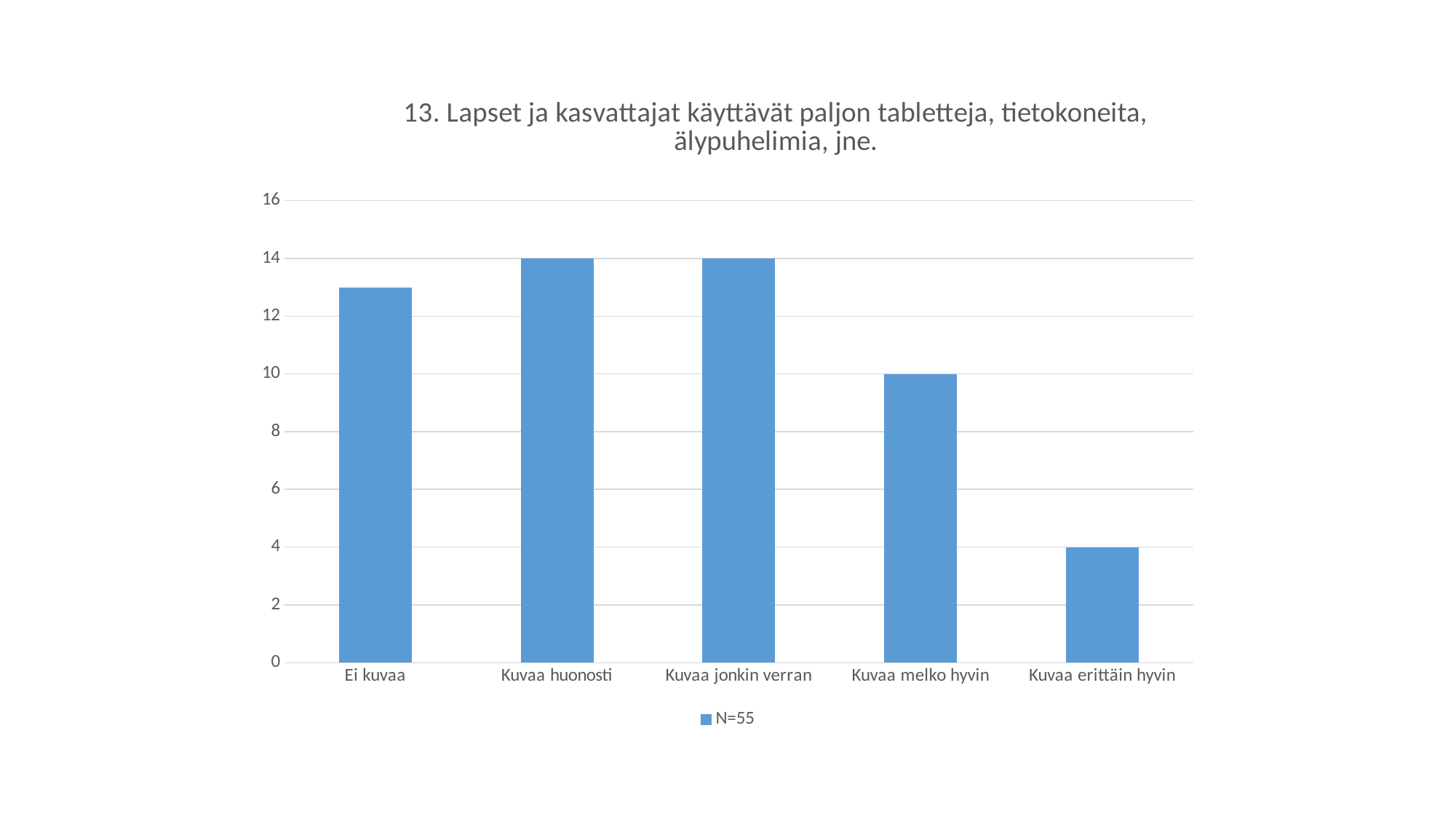
What is the value for Kuvaa huonosti? 14 What is the difference between the values for Kuvaa melko hyvin and Kuvaa erittäin hyvin? 6 What kind of chart is shown on the slide? bar chart Is the value for Ei kuvaa greater or less than 12? greater What is the value for Kuvaa melko hyvin? 10 What is the value for Kuvaa jonkin verran? 14 How many series does the legend list? 1 Which category has the lowest value? Kuvaa erittäin hyvin What is the value for Kuvaa erittäin hyvin? 4 How many categories are shown on the x axis? 5 What is the legend entry shown below the chart? N=55 Which is larger, the value for Kuvaa melko hyvin or the value for Kuvaa erittäin hyvin? Kuvaa melko hyvin